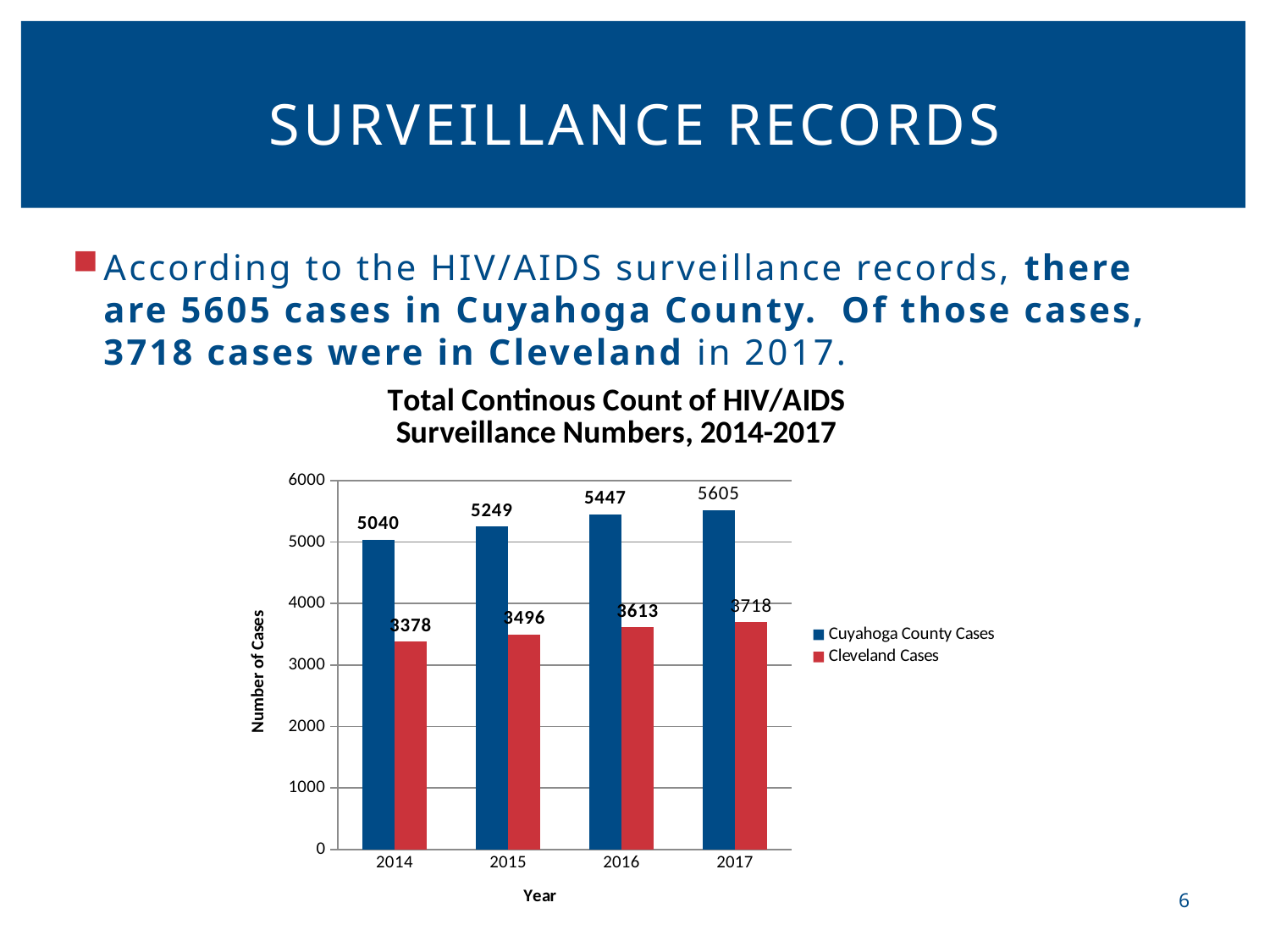
What kind of chart is shown on the slide? Bar chart What is the value for Cuyahoga County Cases in 2014? 5040 What is the difference between Cuyahoga County Cases in 2016 and in 2015? 198 Do the Cleveland Cases values rise or fall from 2014 to 2017? Rise How many years are shown on the x axis? 4 What is the difference between Cuyahoga County Cases and Cleveland Cases in 2017? 1887 What is the value for Cleveland Cases in 2015? 3496 Which year has the lowest value for Cleveland Cases? 2014 How many series does the legend list? 2 Which year has the highest value for Cuyahoga County Cases? 2017 Which is larger: Cleveland Cases in 2017 or Cuyahoga County Cases in 2014? Cuyahoga County Cases in 2014 What is the value for Cleveland Cases in 2016? 3613